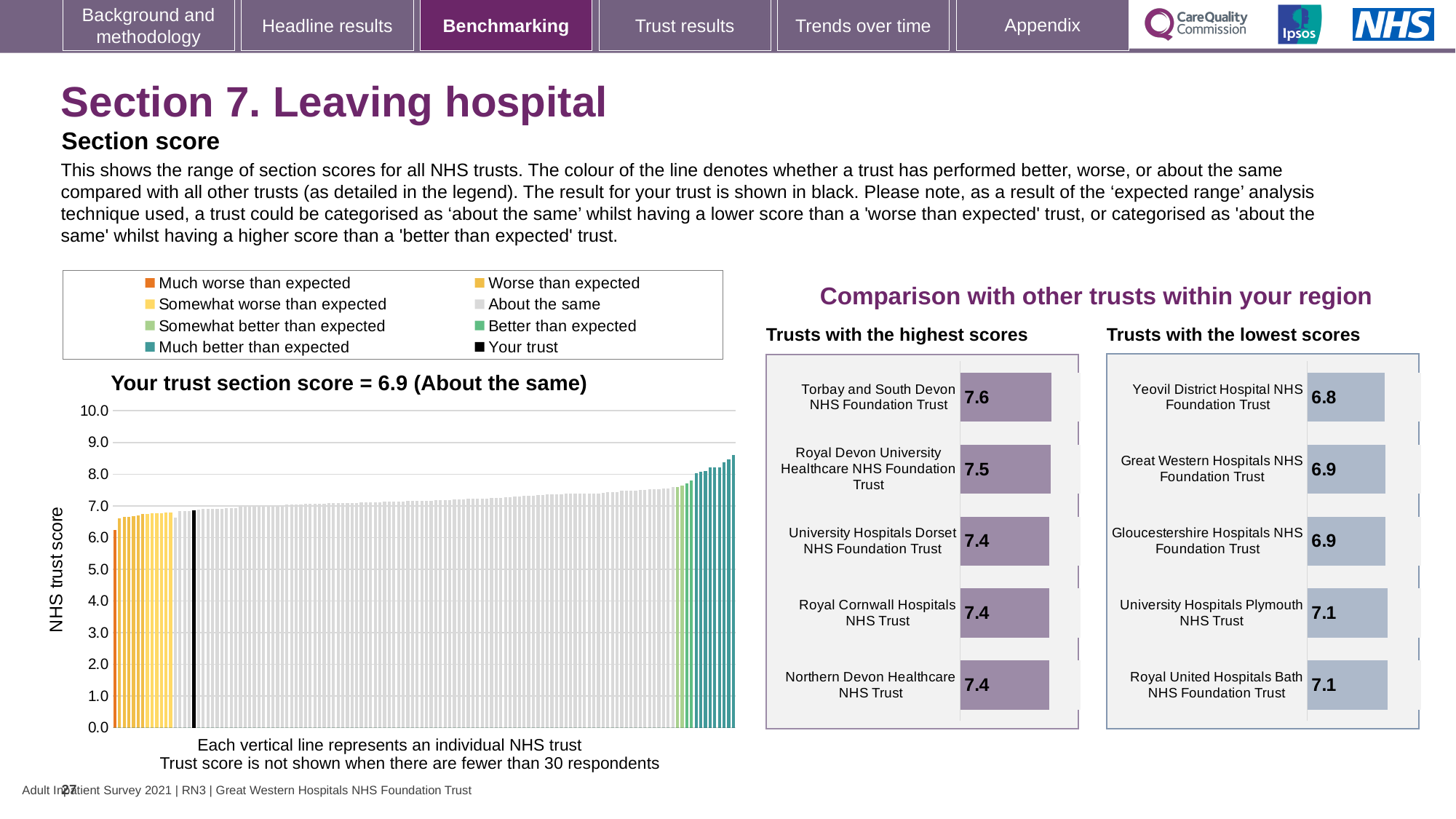
In the 'Trusts with the lowest scores' chart, what is the score for University Hospitals Plymouth NHS Trust? 7.1 In the 'Trusts with the lowest scores' chart, what is the difference between the scores of Royal United Hospitals Bath NHS Foundation Trust and Yeovil District Hospital NHS Foundation Trust? 0.3 In the 'Trusts with the highest scores' chart, what is the score for Torbay and South Devon NHS Foundation Trust? 7.6 In the 'Trusts with the highest scores' chart, which trust has the highest score? Torbay and South Devon NHS Foundation Trust In the main 'Your trust section score' chart, is the value of the tallest bar greater or less than 8.0? greater In the 'Trusts with the highest scores' chart, how many trusts are listed? 5 How many entries does the legend of the main 'Your trust section score' chart list? 8 In the main 'Your trust section score' chart, what is the section score for your trust? 6.9 In the 'Trusts with the highest scores' chart, what is the difference between the scores of Torbay and South Devon NHS Foundation Trust and Royal Devon University Healthcare NHS Foundation Trust? 0.1 In the 'Trusts with the lowest scores' chart, what is the score for Yeovil District Hospital NHS Foundation Trust? 6.8 In the 'Trusts with the lowest scores' chart, which trust has the lowest score? Yeovil District Hospital NHS Foundation Trust In the 'Trusts with the highest scores' chart, what is the score for Royal Devon University Healthcare NHS Foundation Trust? 7.5